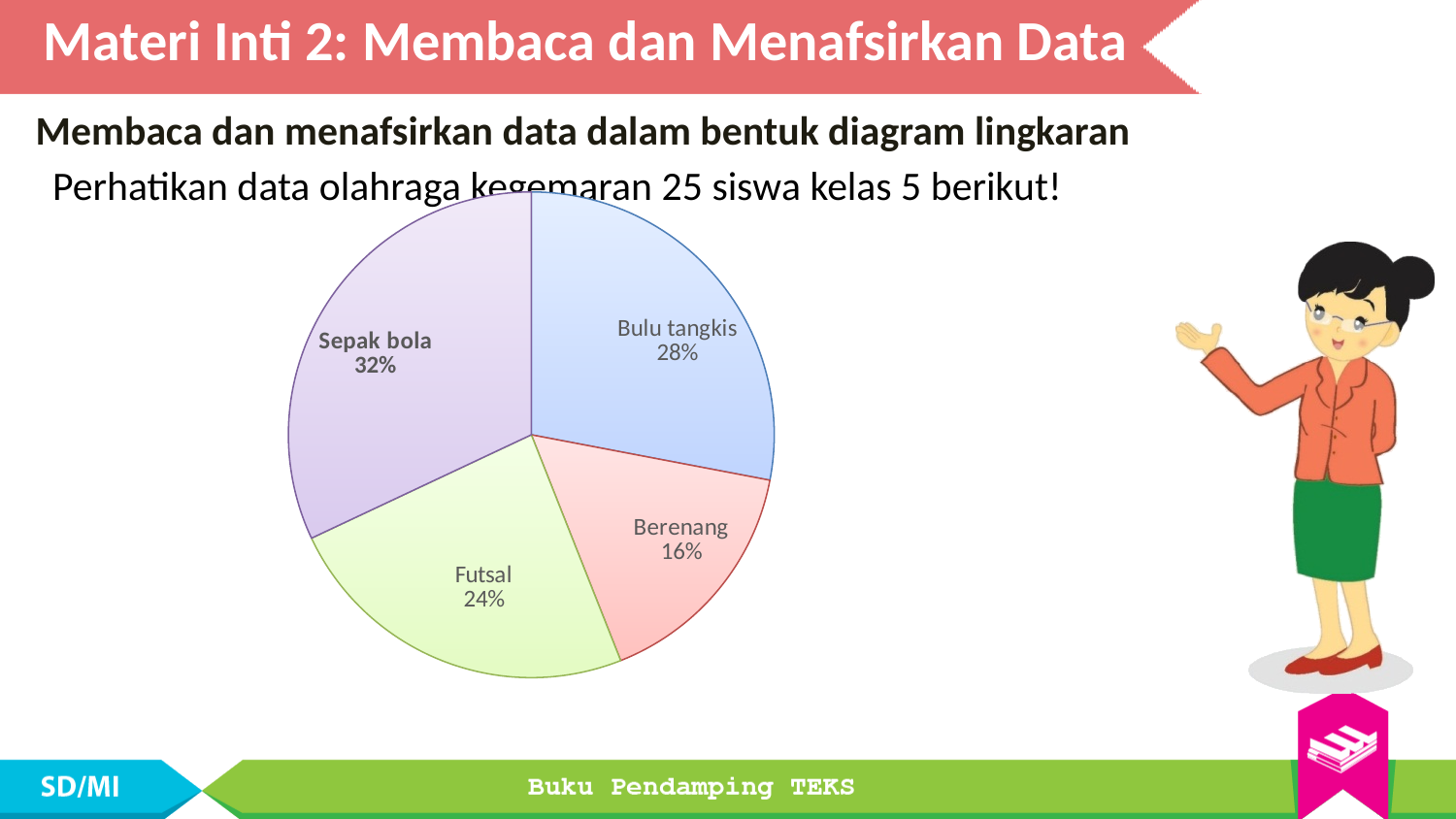
Which sport has the largest share of the pie? Sepak bola What kind of chart is shown on the slide? pie chart What is the combined share of Futsal and Berenang? 40% How many slices does the pie chart have? 4 What percentage of the pie is Bulu tangkis? 28% What percentage of the pie is Berenang? 16% What percentage of the pie is Sepak bola? 32% What is the difference in percentage points between Sepak bola and Berenang? 16 Which is larger, the share for Futsal or the share for Bulu tangkis? Bulu tangkis Which sport has the smallest share of the pie? Berenang What percentage of the pie is Futsal? 24% What colour is the Sepak bola slice? purple